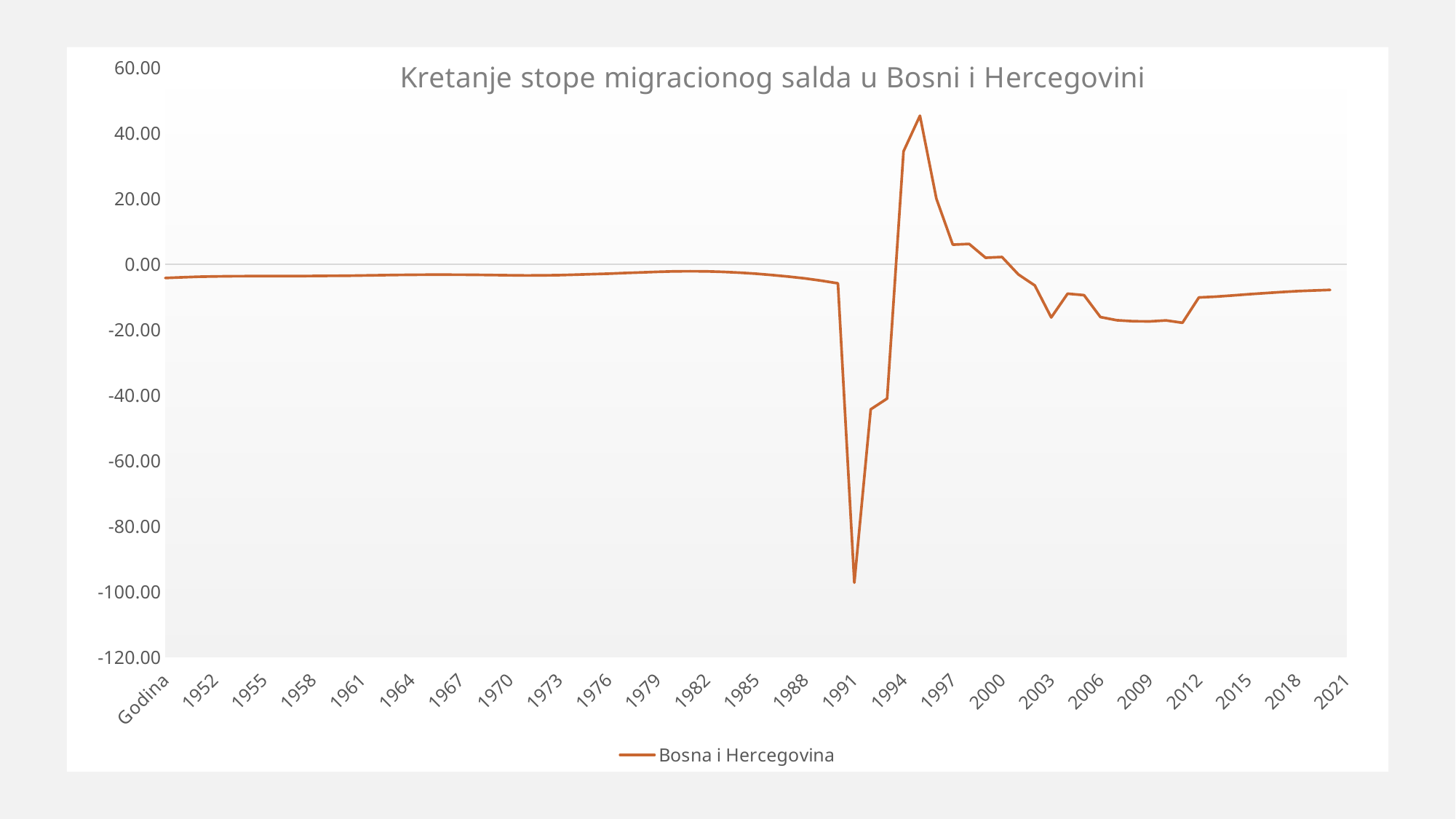
Do the values rise or fall from 1997 to 2003? fall How many series does the legend list? 1 Is the highest value on the line greater or less than 40? greater What is the title of the chart? Kretanje stope migracionog salda u Bosni i Hercegovini Is the value for 2009 greater or less than 0? less Is the value for 1952 greater or less than -20? greater What is the name of the series shown in the legend? Bosna i Hercegovina Do the values rise or fall from 2012 to 2021? rise Which is larger, the value for 1997 or the value for 2006? 1997 What kind of chart is shown on the slide? line chart